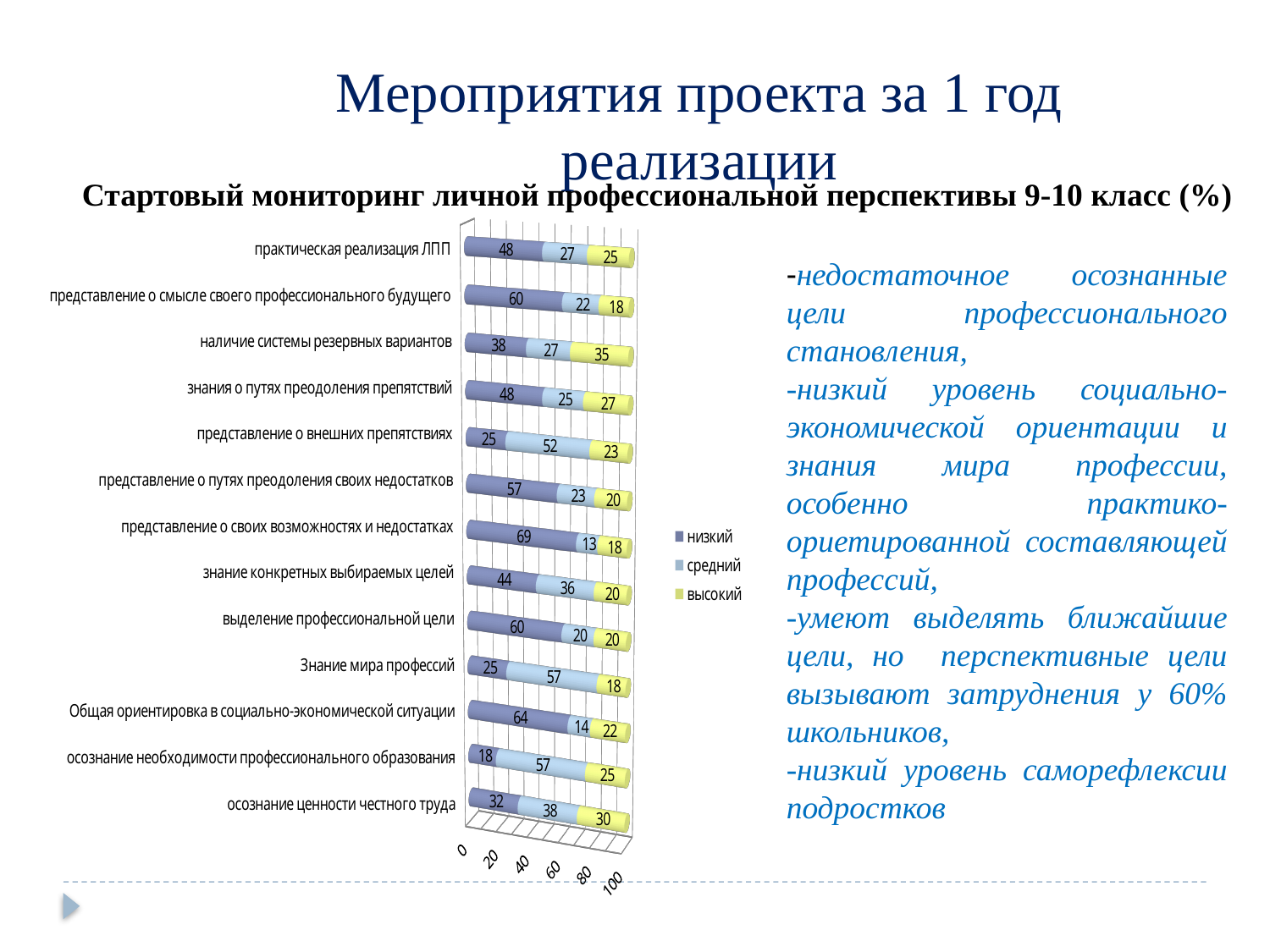
How many series does the legend list? 3 What are the three series listed in the legend? низкий, средний, высокий Which category has the highest value for the низкий series? представление о своих возможностях и недостатках What is the value of the высокий series for наличие системы резервных вариантов? 35 For представление о внешних препятствиях, which is larger: the низкий value or the средний value? средний What is the total of the stacked bar for осознание ценности честного труда? 100 What is the value of the низкий series for практическая реализация ЛПП? 48 What kind of chart is shown on the slide? stacked bar chart Which category has the lowest value for the низкий series? осознание необходимости профессионального образования What is the value of the средний series for Знание мира профессий? 57 How many categories are shown on the chart? 13 What is the difference between the низкий and средний values for Общая ориентировка в социально-экономической ситуации? 50